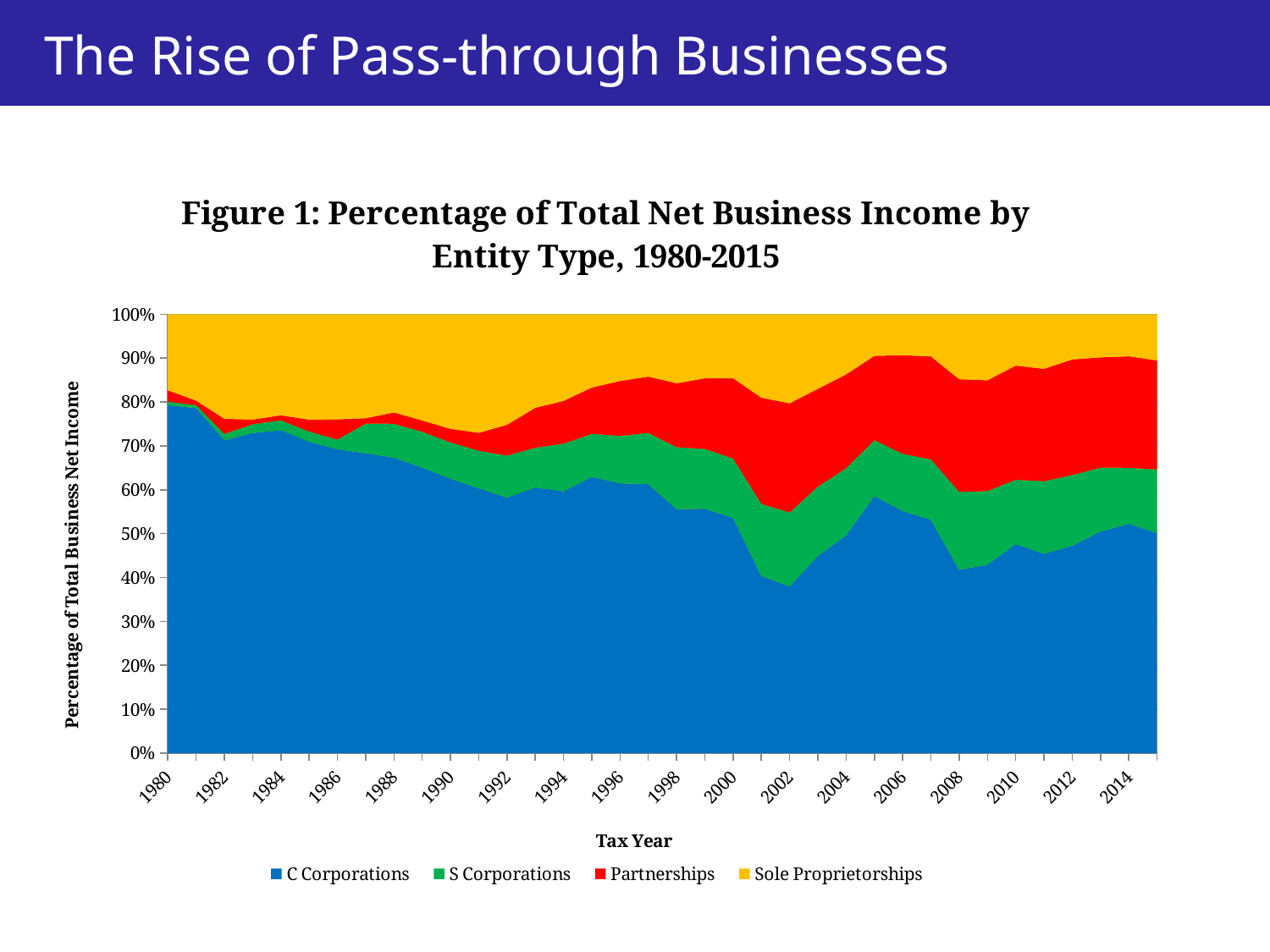
What kind of chart is shown on the slide? Stacked area chart Is the share for C Corporations in 1980 greater or less than 70%? greater Which colour represents Partnerships in the chart? Red Which entity type has the largest share of total net business income in 1980? C Corporations Does the share of net business income for C Corporations rise or fall from 1980 to 2015? Fall In 2015, which has the larger share of net business income: Partnerships or S Corporations? Partnerships What is the title of the chart? Figure 1: Percentage of Total Net Business Income by Entity Type, 1980-2015 Does the share of net business income for Partnerships rise or fall from 1980 to 2015? Rise Is the share for C Corporations in 2002 greater or less than 50%? less How many series does the legend list? 4 Is the share for C Corporations in 2015 greater or less than 40%? greater Which entity type has the smallest share of total net business income in 1980? S Corporations